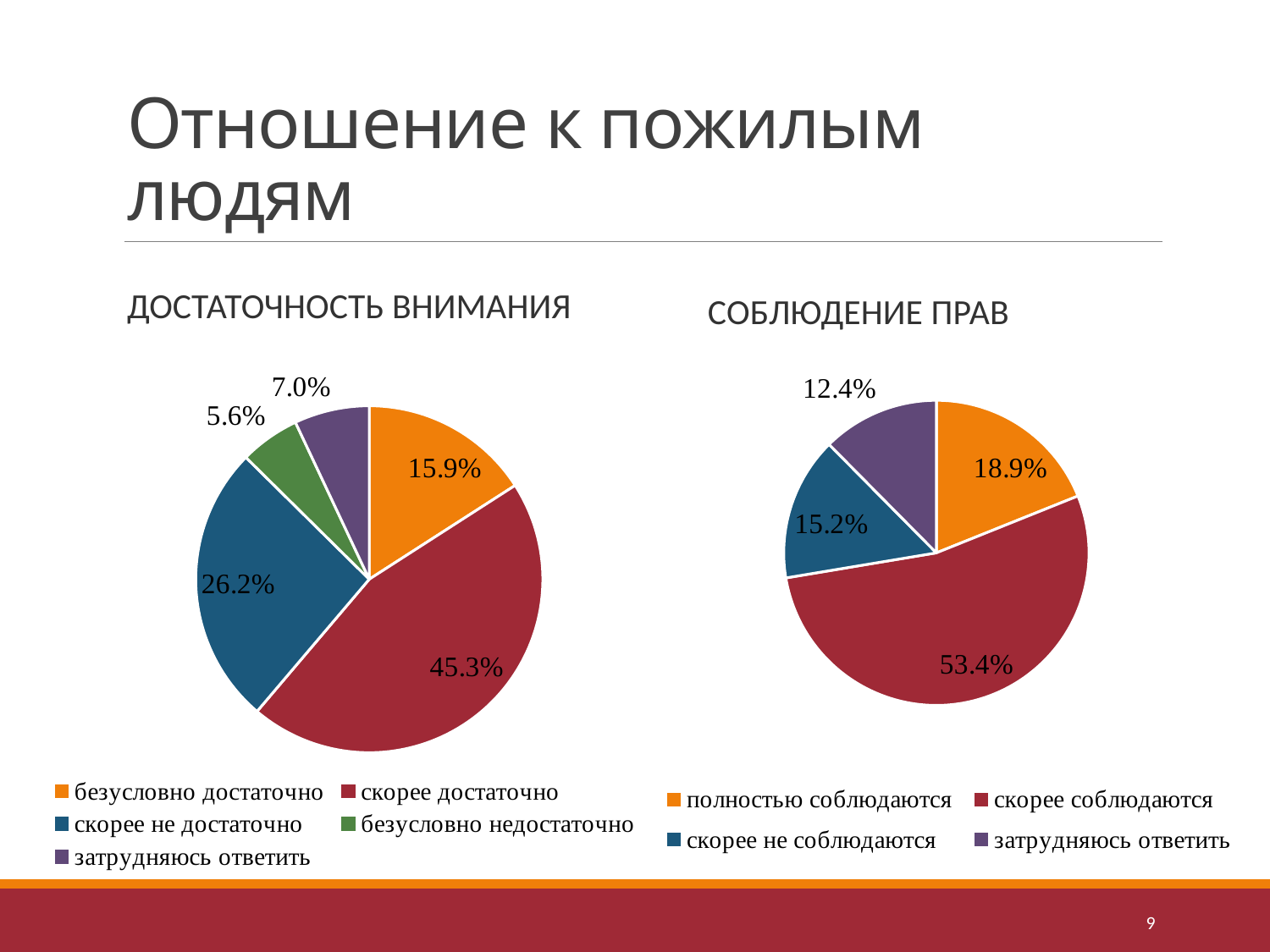
In the "СОБЛЮДЕНИЕ ПРАВ" chart, what is the difference between "скорее соблюдаются" and "полностью соблюдаются"? 34.5% In the "ДОСТАТОЧНОСТЬ ВНИМАНИЯ" chart, what share is labelled for "скорее достаточно"? 45.3% In the "СОБЛЮДЕНИЕ ПРАВ" chart, what share is labelled for "полностью соблюдаются"? 18.9% In the "ДОСТАТОЧНОСТЬ ВНИМАНИЯ" chart, which category has the largest slice? скорее достаточно In the "ДОСТАТОЧНОСТЬ ВНИМАНИЯ" chart, which category has the smallest slice? безусловно недостаточно How many slices does the "ДОСТАТОЧНОСТЬ ВНИМАНИЯ" chart have? 5 In the "ДОСТАТОЧНОСТЬ ВНИМАНИЯ" chart, what share is labelled for "безусловно недостаточно"? 5.6% In the "СОБЛЮДЕНИЕ ПРАВ" chart, what share is labelled for "затрудняюсь ответить"? 12.4% How many entries does the legend of the "СОБЛЮДЕНИЕ ПРАВ" chart list? 4 In the "СОБЛЮДЕНИЕ ПРАВ" chart, which category has the smallest slice? затрудняюсь ответить In the "ДОСТАТОЧНОСТЬ ВНИМАНИЯ" chart, which is larger: "скорее не достаточно" or "безусловно достаточно"? скорее не достаточно What type of chart is used for "СОБЛЮДЕНИЕ ПРАВ"? Pie chart